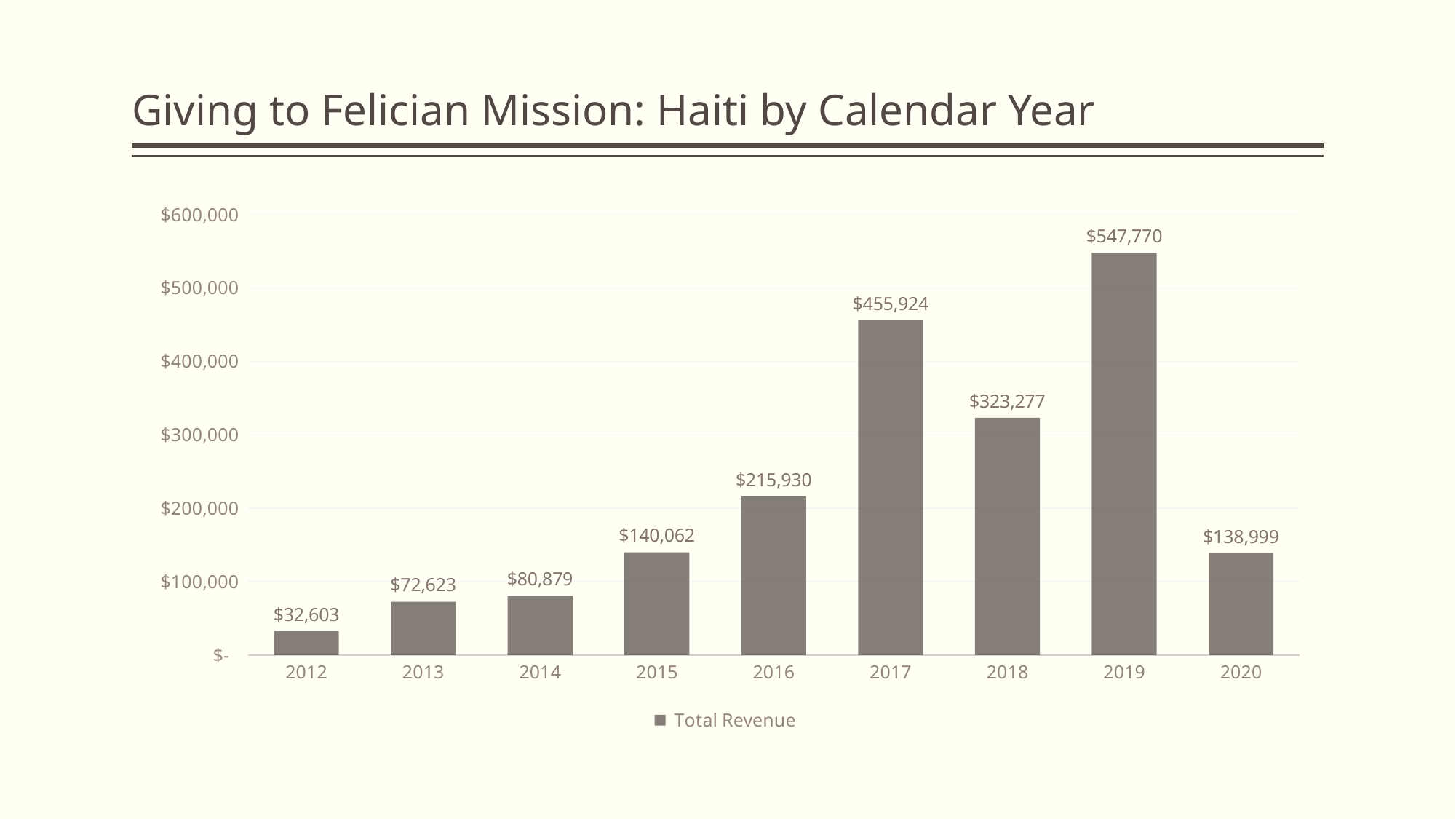
What is the difference in Total Revenue between 2019 and 2017? $91,846 What is the title of the chart? Giving to Felician Mission: Haiti by Calendar Year What kind of chart is shown on the slide? Bar chart What was the Total Revenue for 2017? $455,924 Is the Total Revenue for 2018 greater or less than $300,000? greater Which year had the lowest Total Revenue? 2012 How many years are shown on the x axis? 9 Which year had higher Total Revenue, 2016 or 2018? 2018 What was the Total Revenue for 2020? $138,999 What is the difference in Total Revenue between 2018 and 2016? $107,347 Which year had the highest Total Revenue? 2019 What was the Total Revenue for 2012? $32,603